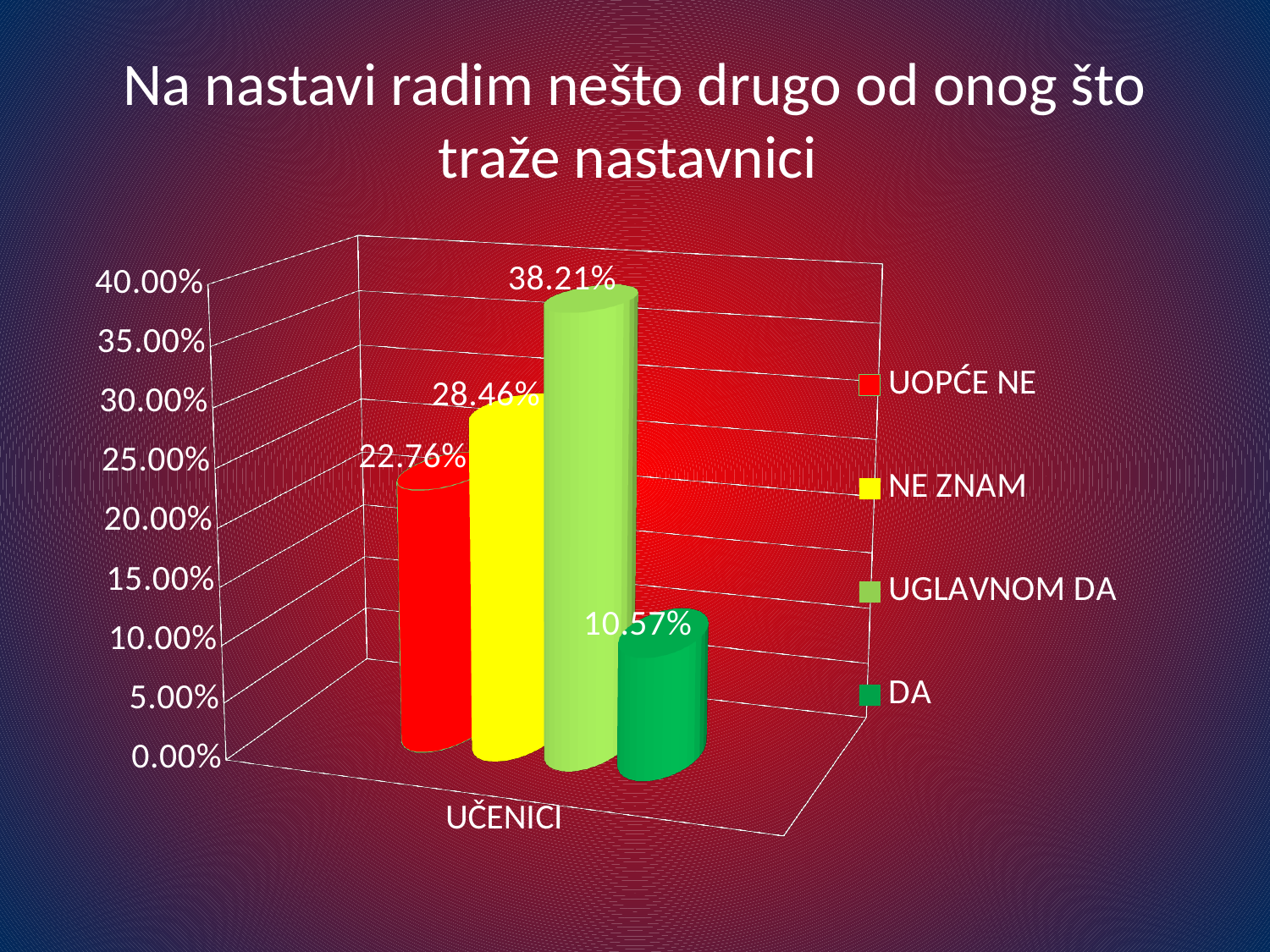
Which series has the highest value? UGLAVNOM DA What is the value for UOPĆE NE? 22.76% What colour is the bar for NE ZNAM? Yellow Which series has the lowest value? DA Which is larger, the value for NE ZNAM or the value for UOPĆE NE? NE ZNAM What is the value for DA? 10.57% What is the value for UGLAVNOM DA? 38.21% What is the category label on the x axis? UČENICI How many series does the legend list? 4 What kind of chart is shown on the slide? Bar chart What is the difference between the values for UGLAVNOM DA and DA? 27.64% What is the value for NE ZNAM? 28.46%